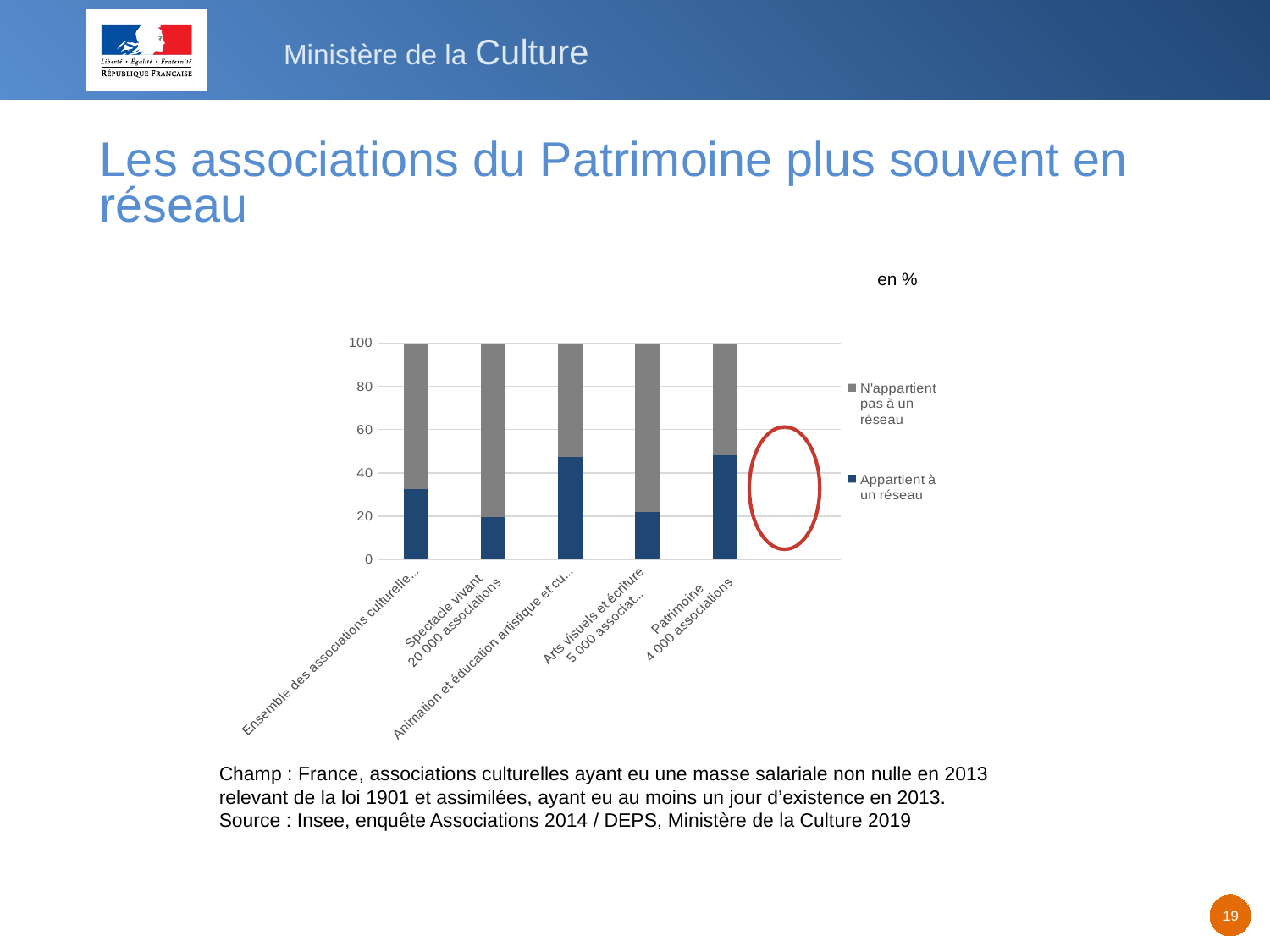
Which has a larger 'Appartient à un réseau' value: 'Animation et éducation artistique' or 'Arts visuels et écriture'? Animation et éducation artistique How many series does the chart legend list? 2 What unit is indicated above the chart? en % Is the value of 'Appartient à un réseau' for 'Animation et éducation artistique' greater or less than 40? greater How many categories are plotted along the x axis of the chart? 5 Which has a larger 'Appartient à un réseau' value: 'Patrimoine 4 000 associations' or 'Spectacle vivant 20 000 associations'? Patrimoine 4 000 associations Is the value of 'Appartient à un réseau' for 'Ensemble des associations culturelles' greater or less than 20? greater What is the total height of each stacked bar in the chart? 100 What kind of chart is shown on the slide? Stacked bar chart Is the value of 'Appartient à un réseau' for 'Spectacle vivant 20 000 associations' greater or less than 40? less What are the two series named in the chart legend? N'appartient pas à un réseau; Appartient à un réseau